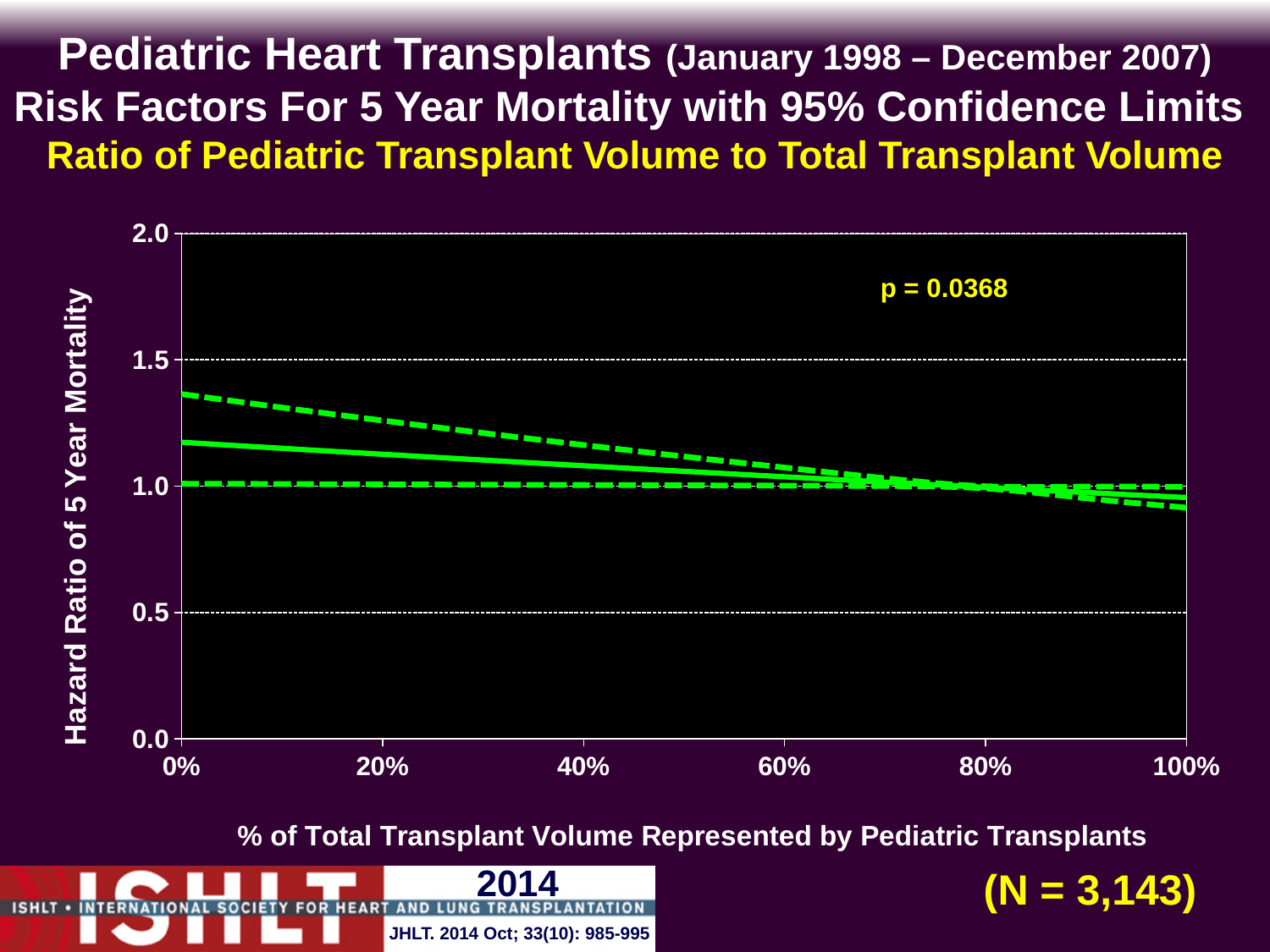
How many lines are plotted on the chart? 3 What p-value is printed on the chart? p = 0.0368 Is the lower dashed confidence limit at 100% greater or less than 1.5? less Is the upper dashed confidence limit at 20% greater or less than 1.0? greater What is the label of the y axis? Hazard Ratio of 5 Year Mortality Is the value of the solid hazard ratio line at 0% greater or less than 1.0? greater What kind of chart is shown on the slide? line chart Does the solid hazard ratio line rise or fall as the percentage of total transplant volume represented by pediatric transplants increases from 0% to 100%? fall Does the upper dashed confidence limit rise or fall along the x axis? fall